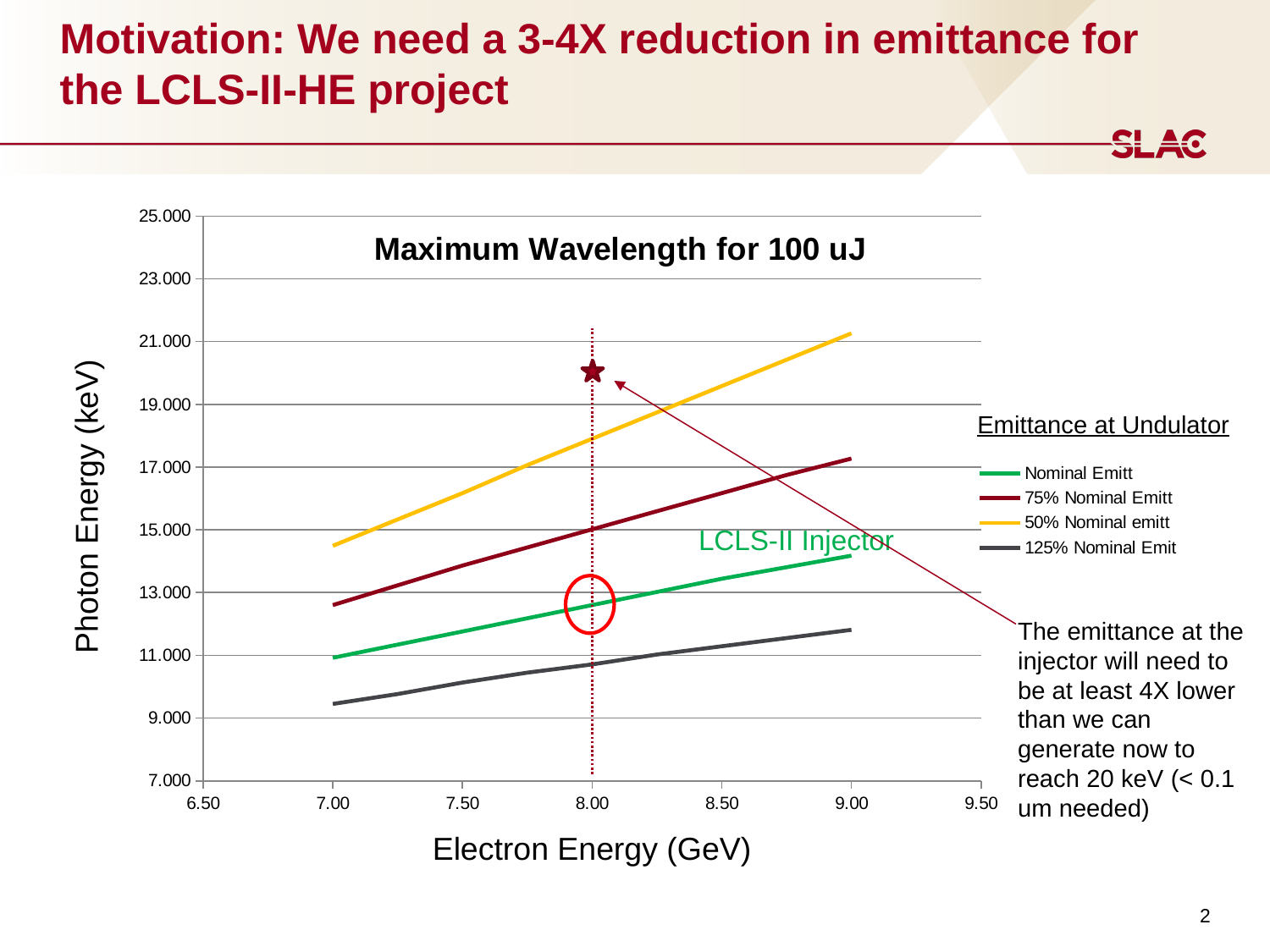
How many series does the legend list? 4 What is the label of the x axis? Electron Energy (GeV) Which series has the highest photon energy across the plotted electron energies? 50% Nominal emitt Is the value for Nominal Emitt at 8.00 GeV greater or less than 11.000? greater Is the value for 125% Nominal Emit at 7.00 GeV greater or less than 11.000? less Which series has the lowest photon energy across the plotted electron energies? 125% Nominal Emit At 8.00 GeV, which is larger: the value for 75% Nominal Emitt or the value for Nominal Emitt? 75% Nominal Emitt Is the value for 75% Nominal Emitt at 9.00 GeV greater or less than 15.000? greater What kind of chart is shown on the slide? line chart Do the photon energy values rise or fall as electron energy increases from 7.00 to 9.00 GeV? rise What is the title of the chart? Maximum Wavelength for 100 uJ